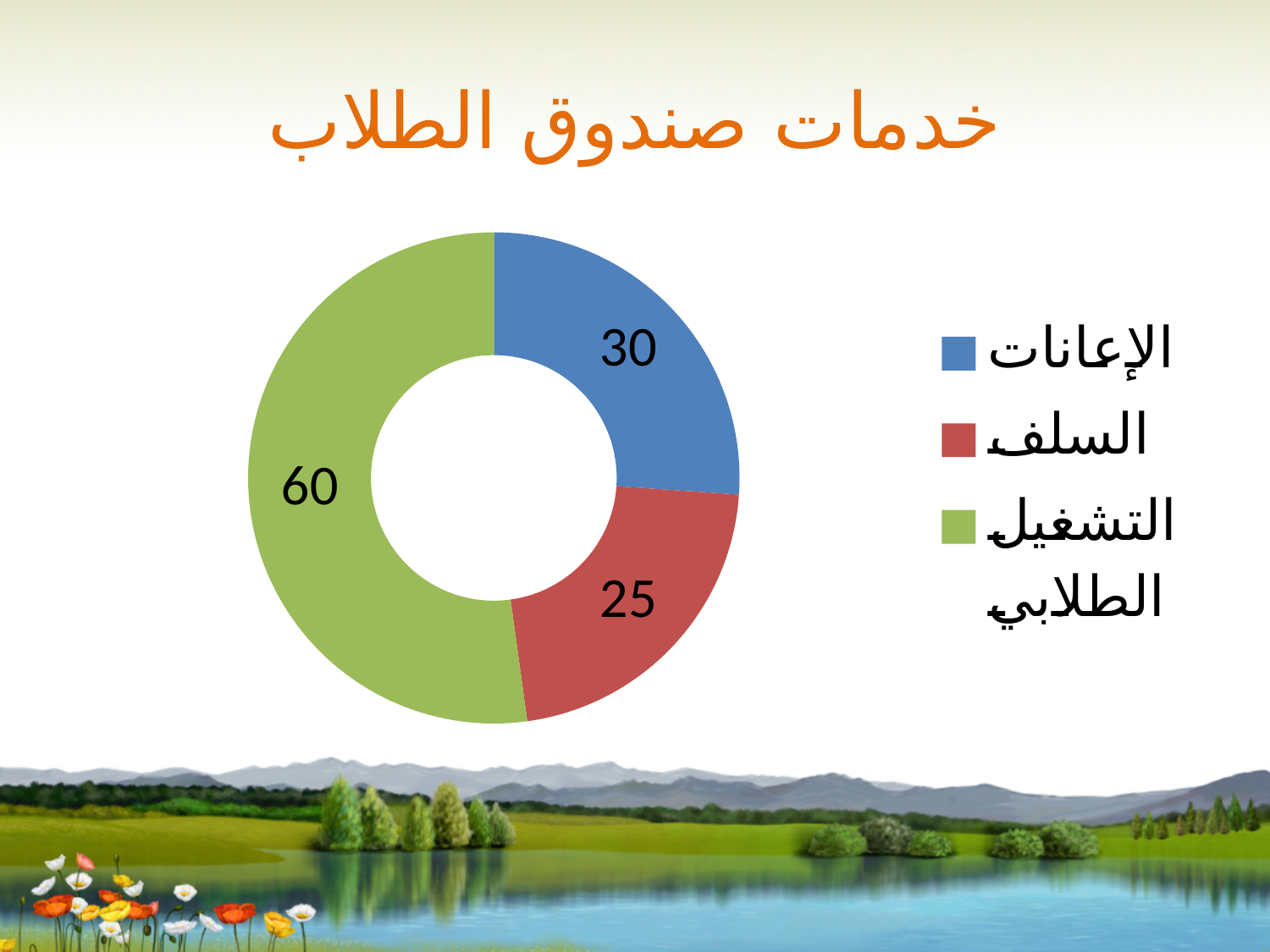
Which is larger, the value for الإعانات or the value for السلف? الإعانات What is the total of all the values shown in the chart? 115 What value is shown for التشغيل الطلابي in the chart? 60 What value is shown for الإعانات in the chart? 30 Which category has the largest value in the chart? التشغيل الطلابي What kind of chart is shown on the slide? Doughnut chart What is the difference between the values for التشغيل الطلابي and الإعانات? 30 How many categories does the chart show? 3 What colour represents التشغيل الطلابي in the chart? Green Which category has the smallest value in the chart? السلف What value is shown for السلف in the chart? 25 What is the difference between the values for الإعانات and السلف? 5